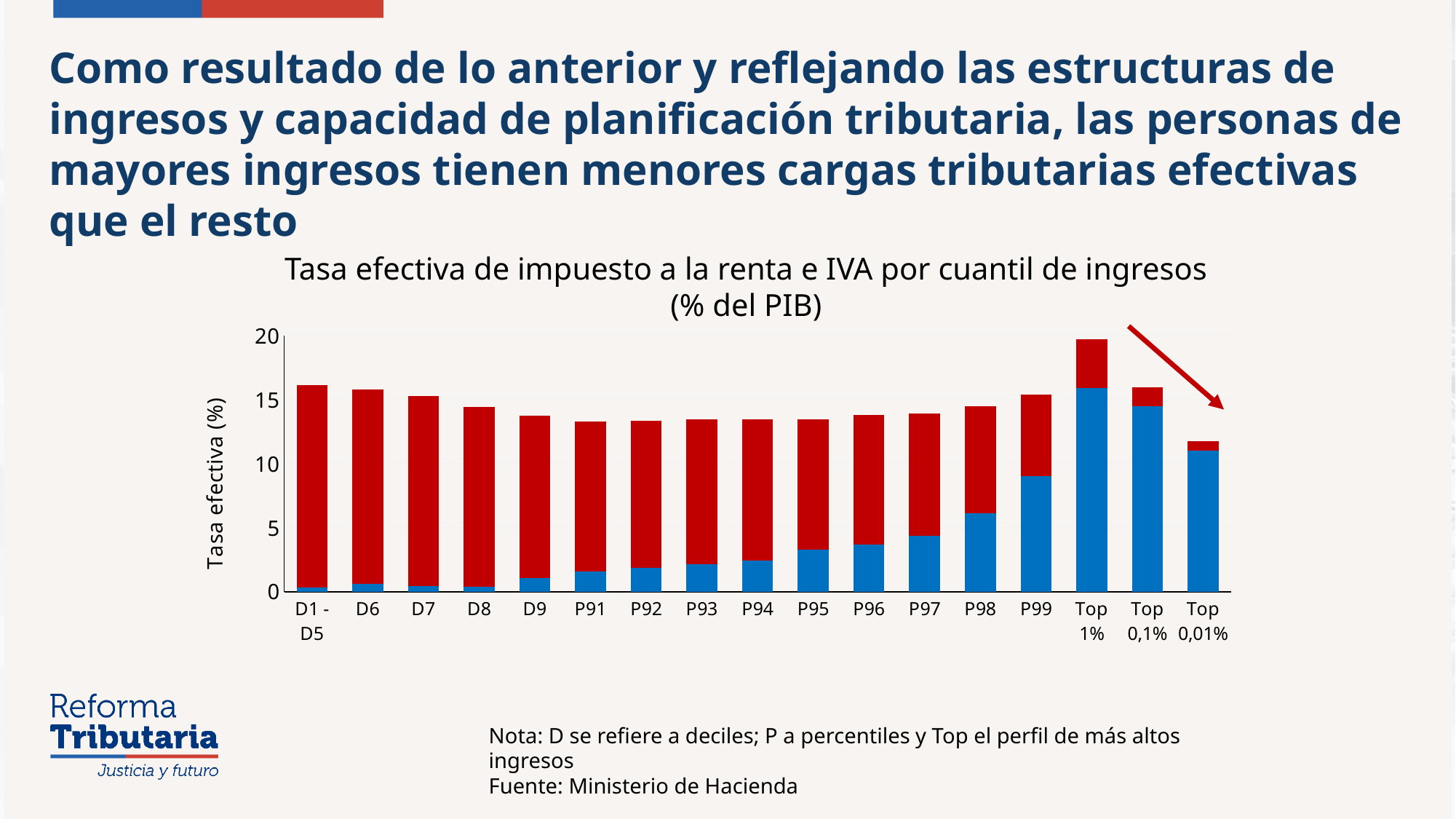
What kind of chart is shown on the slide? Stacked bar chart Is the total value for Top 0,01% greater or less than 15? less Is the blue portion of the P99 bar greater or less than 10? less Is the total value for D9 greater or less than 15? less Which has a larger total effective tax rate, D6 or D9? D6 Which has a larger total effective tax rate, D1 - D5 or Top 0,01%? D1 - D5 Do the total values rise or fall from D1 - D5 to D9? fall Which category has the lowest total effective tax rate? Top 0,01% Which category has the highest total effective tax rate? Top 1% What is the label of the y axis? Tasa efectiva (%) How many income quantile categories are shown on the x axis? 17